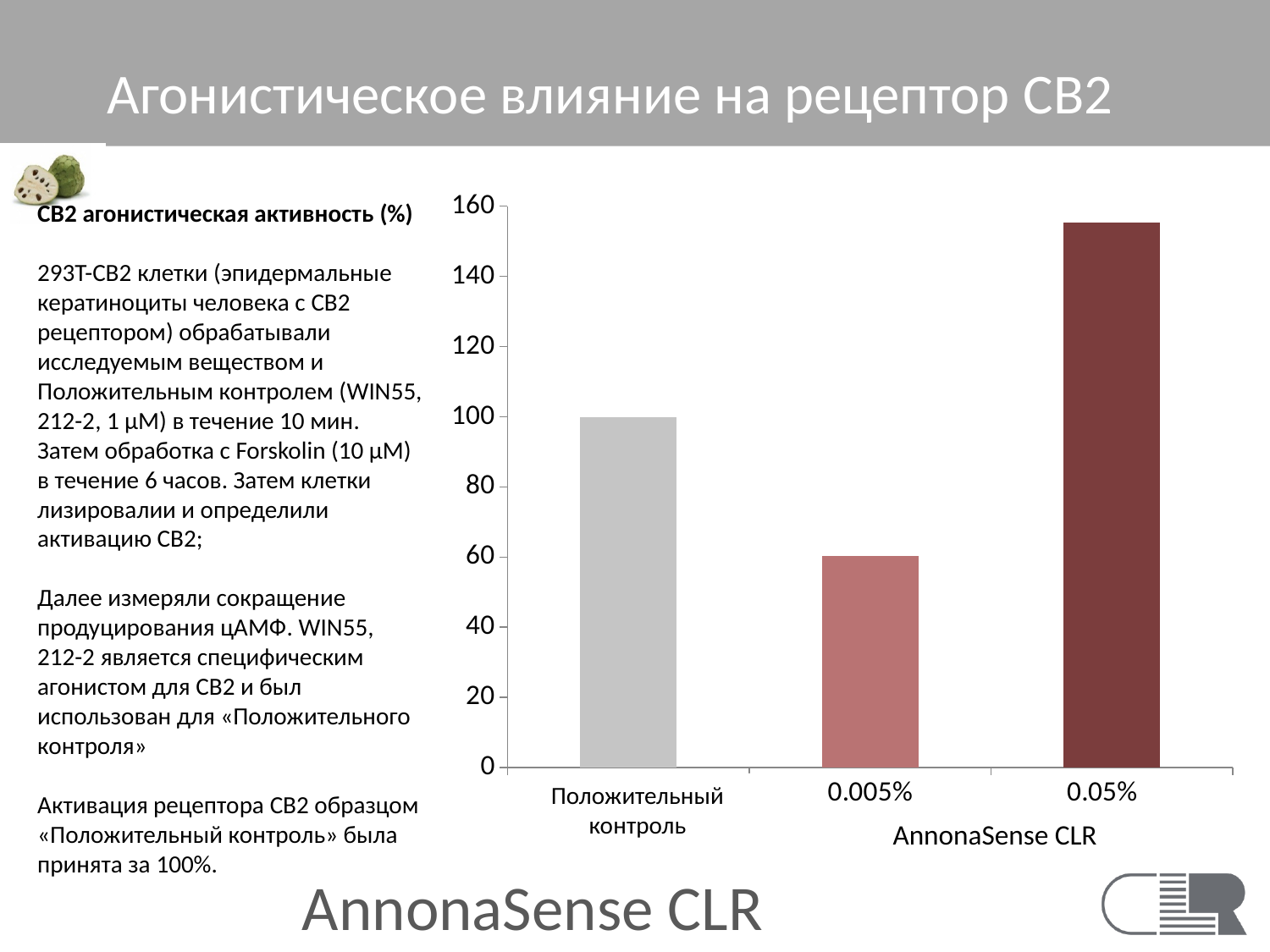
Which category has the lowest value? 0.005% Is the value for the 0.05% concentration greater or less than 140? greater What is the value for Положительный контроль? 100 How many bars are shown in the chart? 3 Which is larger, the value for Положительный контроль or the value for 0.005%? Положительный контроль Which category has the highest value? 0.05% Is the value for the 0.05% concentration greater or less than 160? less What is the maximum value shown on the vertical axis? 160 What product name is written under the 0.005% and 0.05% categories on the x axis? AnnonaSense CLR What kind of chart is shown on the slide? bar chart